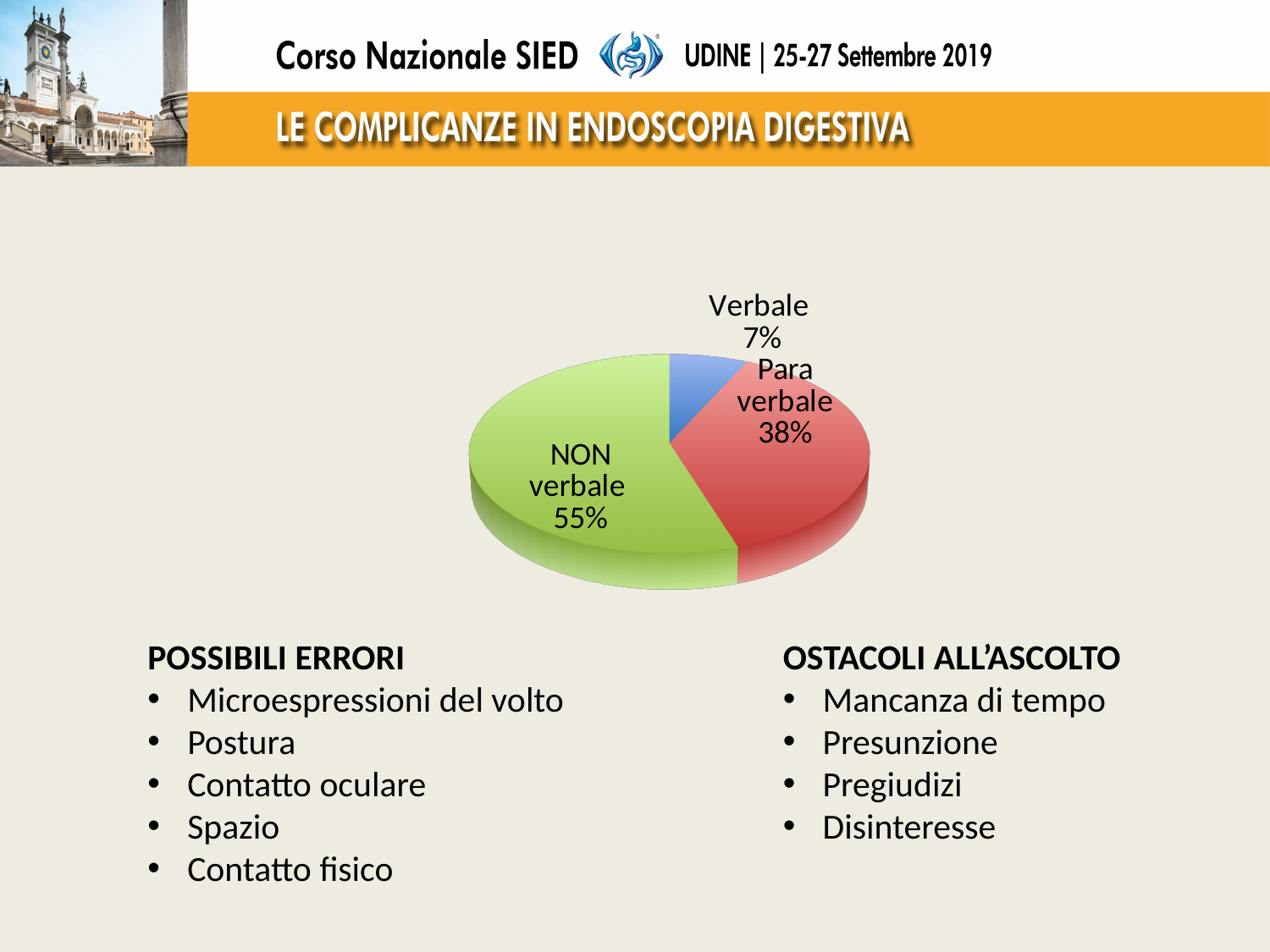
What is the difference in percentage points between the Para verbale and Verbale slices? 31 What colour is the Verbale slice of the pie? blue How many slices does the pie chart have? 3 What colour is the NON verbale slice of the pie? green Which slice of the pie is the smallest? Verbale What share of the pie does the NON verbale slice represent? 55% What share of the pie does the Verbale slice represent? 7% What kind of chart is shown on the slide? pie chart What share of the pie does the Para verbale slice represent? 38% What is the difference in percentage points between the NON verbale and Para verbale slices? 17 Which is larger, the Para verbale slice or the Verbale slice? Para verbale Which slice of the pie is the largest? NON verbale